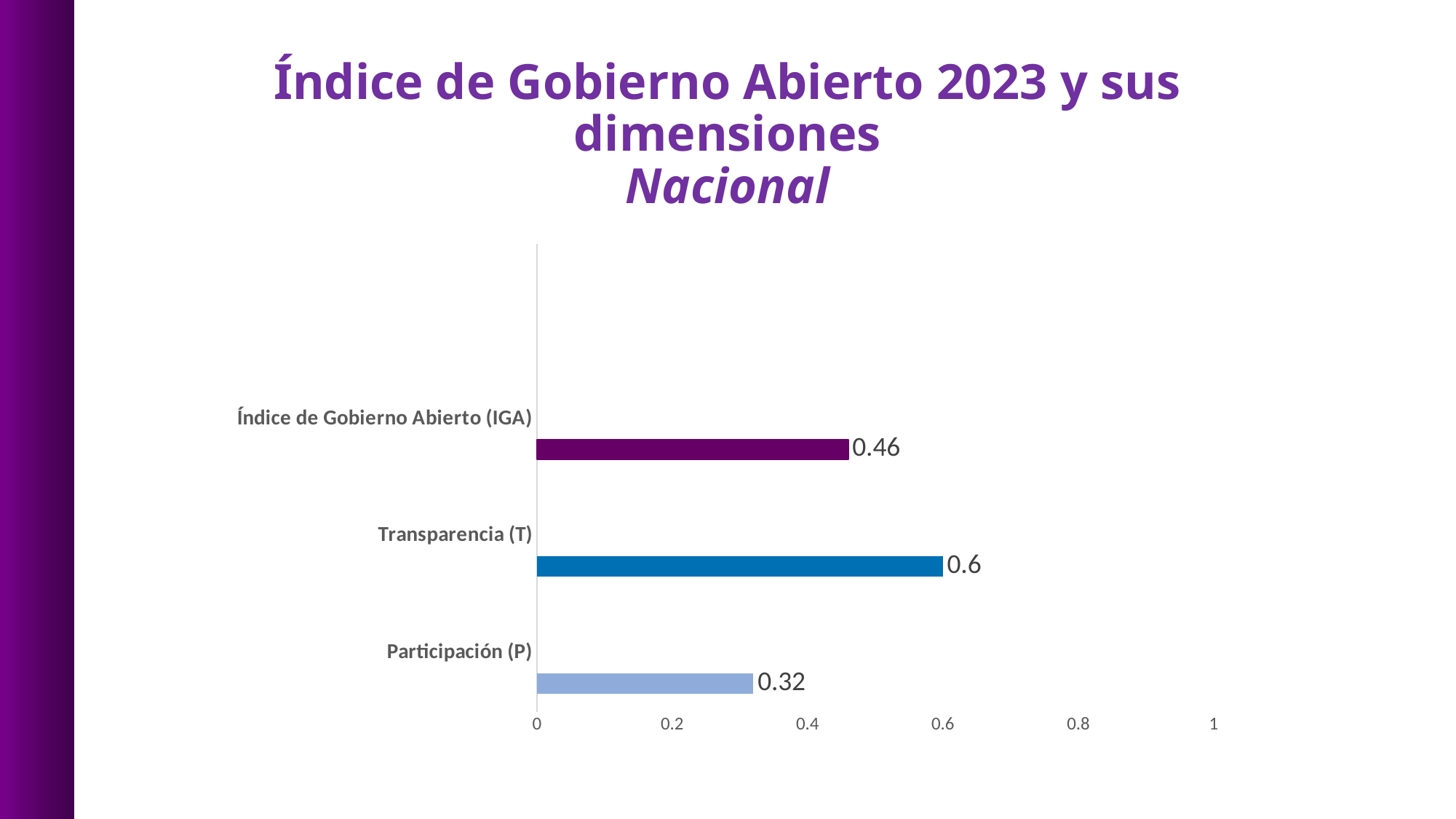
What kind of chart is shown on the slide? Bar chart Is the value for Índice de Gobierno Abierto (IGA) greater or less than 0.4? greater What is the difference between the values for Transparencia (T) and Participación (P)? 0.28 What is the value for Participación (P)? 0.32 What is the value for Transparencia (T)? 0.6 What is the difference between the values for Índice de Gobierno Abierto (IGA) and Participación (P)? 0.14 What is the value for Índice de Gobierno Abierto (IGA)? 0.46 Which category has the lowest value? Participación (P) Which is larger, the value for Índice de Gobierno Abierto (IGA) or the value for Transparencia (T)? Transparencia (T) How many categories are shown in the chart? 3 Which category has the highest value? Transparencia (T) What is the title of the slide? Índice de Gobierno Abierto 2023 y sus dimensiones Nacional